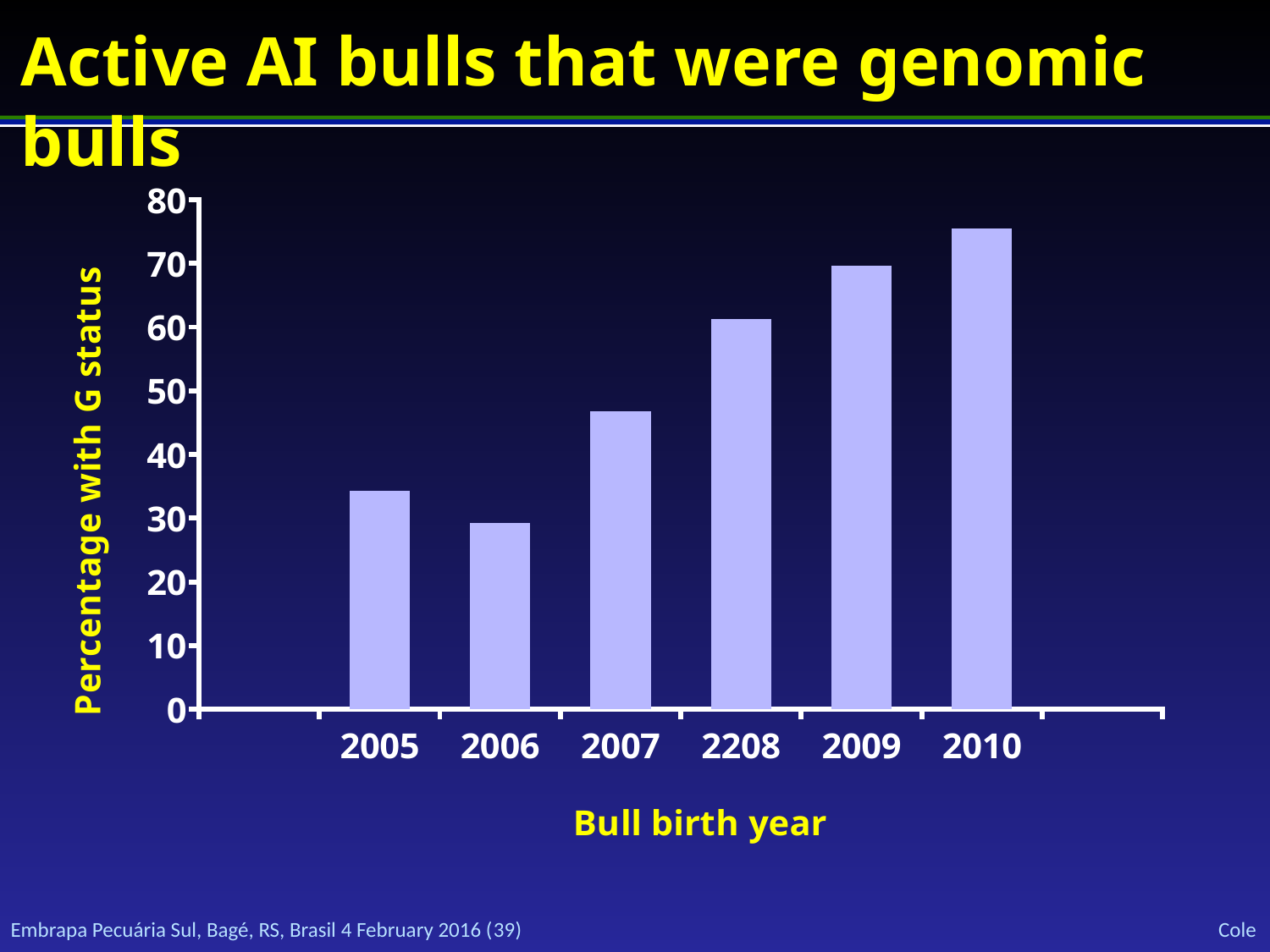
Is the percentage with G status for bull birth year 2005 greater or less than 30? greater What kind of chart is shown on the slide? bar chart Which bull birth year has the lowest percentage with G status? 2006 Is the percentage with G status for bull birth year 2009 greater or less than 60? greater Which has a higher percentage with G status: bull birth year 2007 or 2009? 2009 How many bull birth years are plotted in the chart? 6 Is the percentage with G status for bull birth year 2010 greater or less than 70? greater From bull birth year 2006 to 2010, do the percentages with G status rise or fall? rise What is the label of the x axis of the chart? Bull birth year Which bull birth year has the highest percentage with G status? 2010